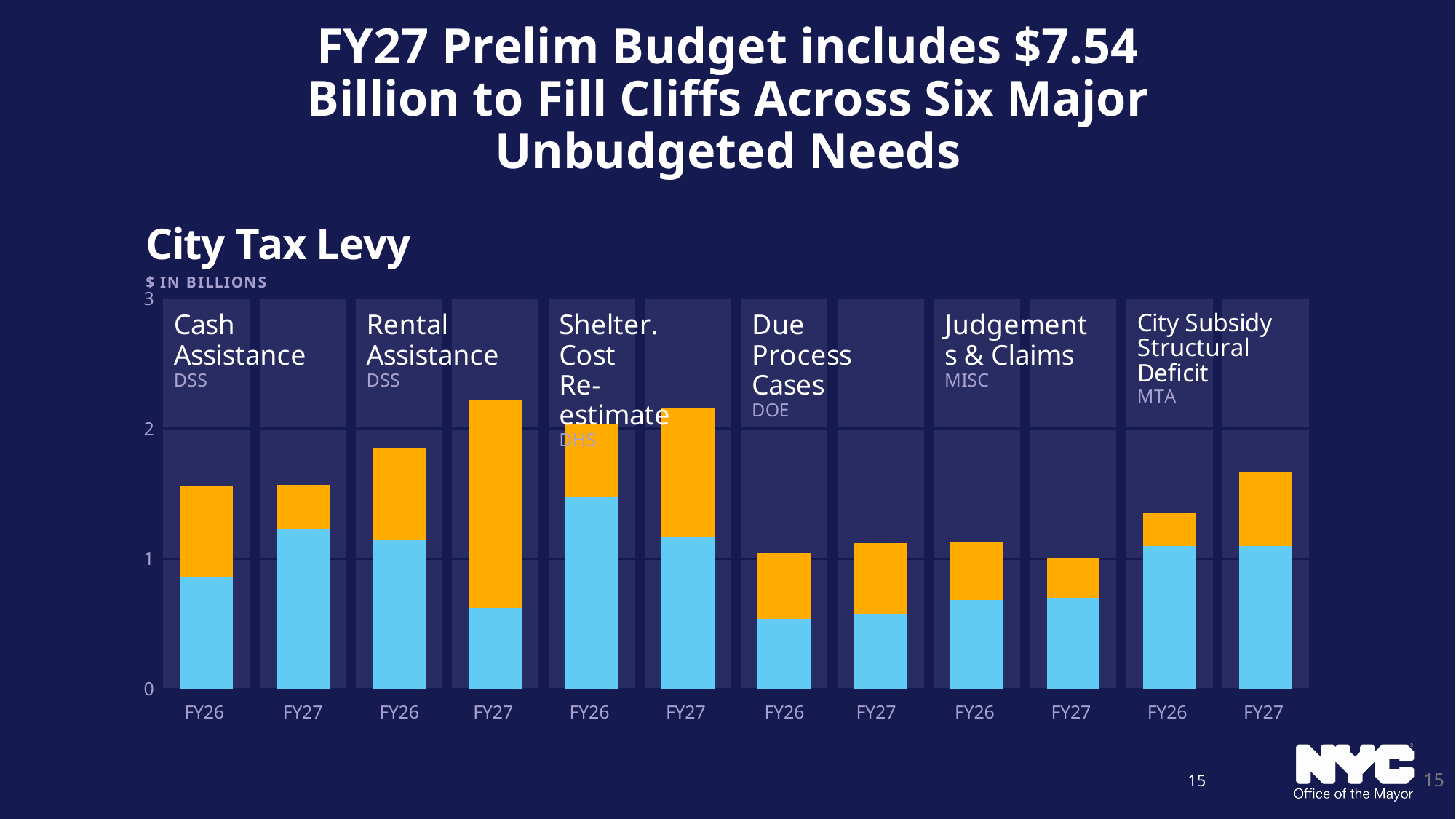
How many bars are plotted in total on the chart? 12 Is the value for City Subsidy Structural Deficit FY27 greater or less than 2? less In what units are the chart's values expressed? $ in billions For Judgements & Claims, which bar is taller, FY26 or FY27? FY26 For Rental Assistance, which bar is taller, FY26 or FY27? FY27 Is the value for Rental Assistance FY27 greater or less than 2? greater For City Subsidy Structural Deficit, which bar is taller, FY26 or FY27? FY27 Is the value for Rental Assistance FY26 greater or less than 2? less How many need categories (groups of bars) does the chart show? 6 What is the title of the chart? City Tax Levy What kind of chart is shown on the slide? bar chart